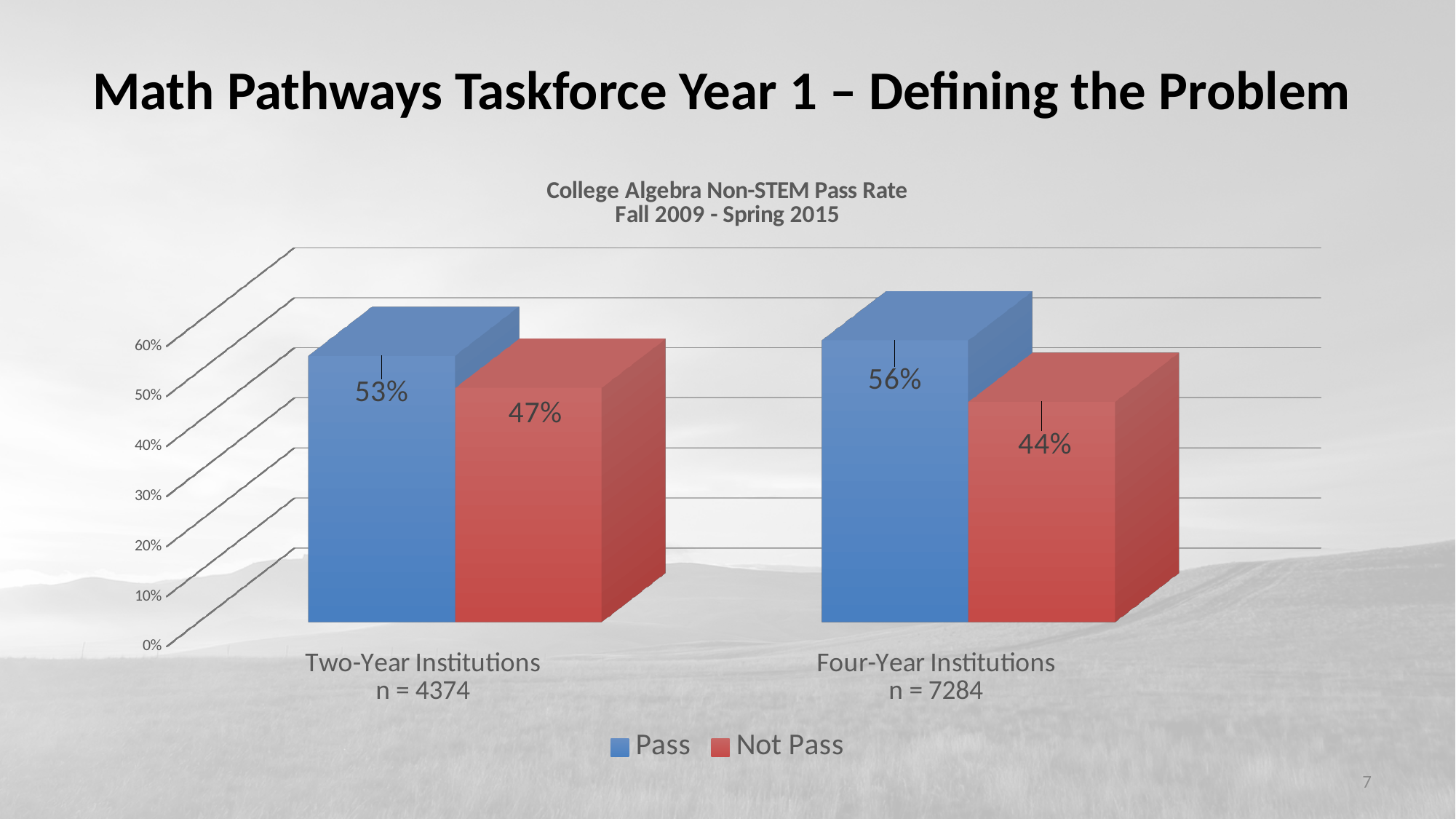
What is the Not Pass rate for Four-Year Institutions? 44% How many series does the legend list? 2 What is the Not Pass rate for Two-Year Institutions? 47% What is the Pass rate for Four-Year Institutions? 56% What is the sample size (n) shown for Four-Year Institutions? n = 7284 Is the Pass rate for Two-Year Institutions or Four-Year Institutions larger? Four-Year Institutions What kind of chart is shown on the slide? Bar chart Which institution type has the lower Not Pass rate? Four-Year Institutions What is the difference between the Pass and Not Pass rates for Four-Year Institutions? 12% Which institution type has the higher Pass rate? Four-Year Institutions How many institution categories are shown on the x axis? 2 What is the Pass rate for Two-Year Institutions? 53%